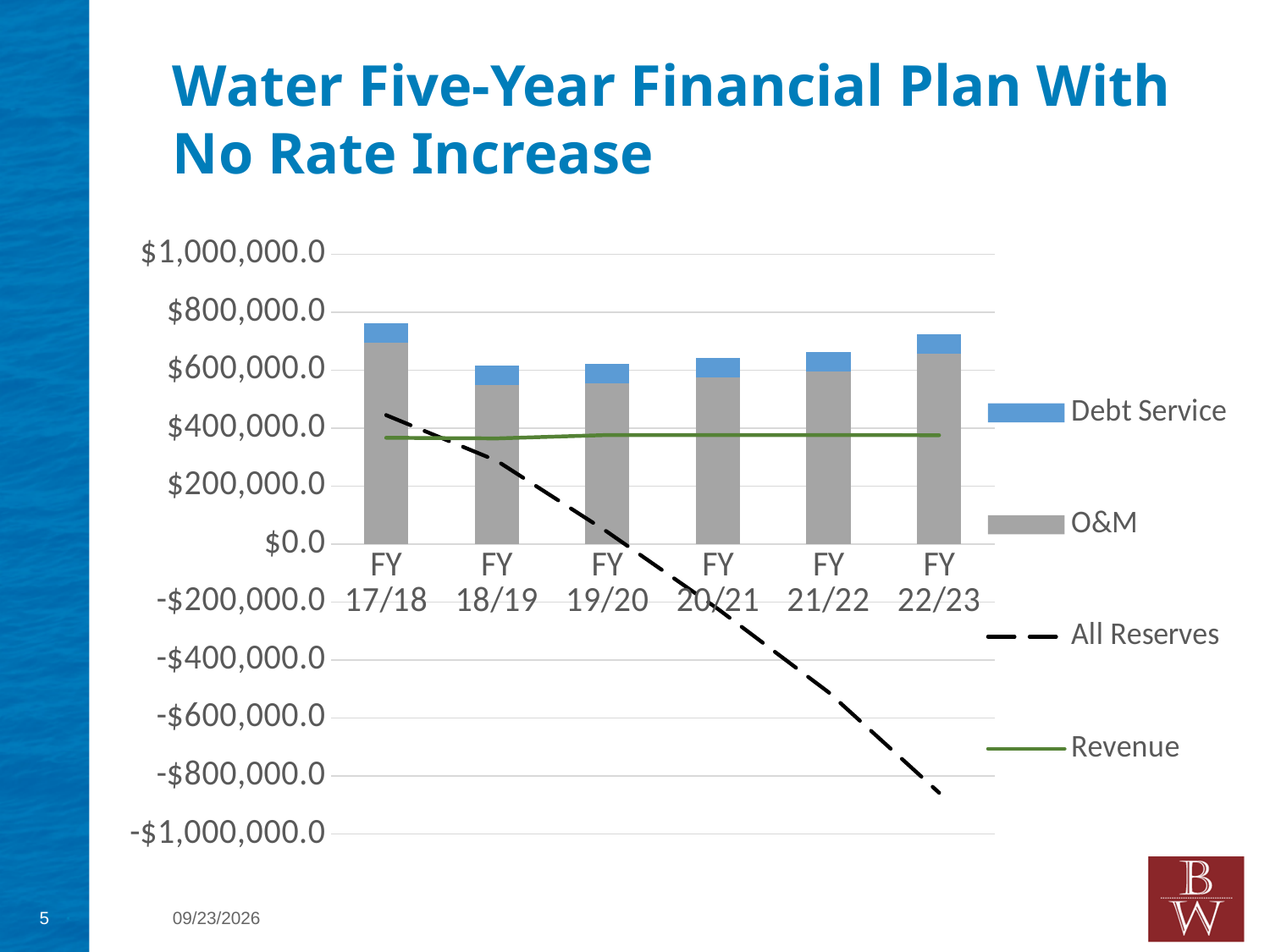
Does the All Reserves line rise or fall from FY 17/18 to FY 22/23? Fall Which fiscal year has the highest All Reserves value? FY 17/18 How many series does the chart legend list? 4 Is the O&M value for FY 17/18 greater or less than $600,000.0? greater What kind of chart is shown on the slide? A combination of a stacked bar chart and line chart Is the Revenue value for FY 19/20 greater or less than $400,000.0? less Is the All Reserves value for FY 22/23 greater or less than -$600,000.0? less Which series are listed in the chart legend? Debt Service, O&M, All Reserves, Revenue Which is larger, the O&M value for FY 17/18 or for FY 18/19? FY 17/18 How many fiscal years are shown on the x axis of the chart? 6 What is the title of the slide containing the chart? Water Five-Year Financial Plan With No Rate Increase